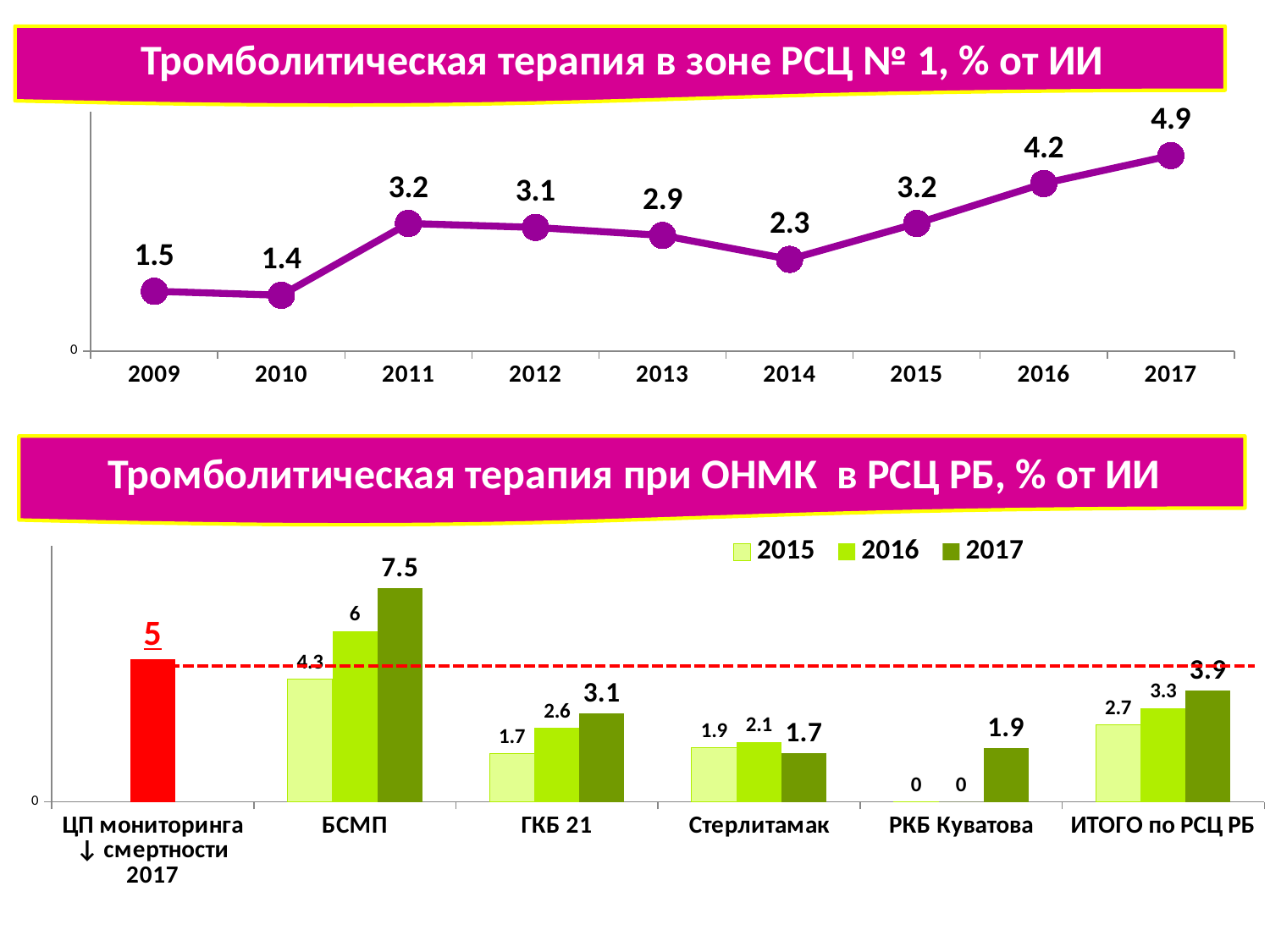
In the bottom chart 'Тромболитическая терапия при ОНМК в РСЦ РБ, % от ИИ', how many series does the legend list? 3 What kind of chart is the top chart 'Тромболитическая терапия в зоне РСЦ № 1, % от ИИ'? line chart In the top chart 'Тромболитическая терапия в зоне РСЦ № 1, % от ИИ', how many years are plotted? 9 In the bottom chart 'Тромболитическая терапия при ОНМК в РСЦ РБ, % от ИИ', what is the difference between the 2017 and 2015 values for ИТОГО по РСЦ РБ? 1.2 In the top chart 'Тромболитическая терапия в зоне РСЦ № 1, % от ИИ', what is the value for 2017? 4.9 In the bottom chart 'Тромболитическая терапия при ОНМК в РСЦ РБ, % от ИИ', what is the 2016 value for ГКБ 21? 2.6 In the bottom chart 'Тромболитическая терапия при ОНМК в РСЦ РБ, % от ИИ', which is larger for Стерлитамак: the 2016 value or the 2017 value? 2016 In the top chart 'Тромболитическая терапия в зоне РСЦ № 1, % от ИИ', what is the value for 2014? 2.3 In the bottom chart 'Тромболитическая терапия при ОНМК в РСЦ РБ, % от ИИ', what is the 2017 value for БСМП? 7.5 In the top chart 'Тромболитическая терапия в зоне РСЦ № 1, % от ИИ', which year has the lowest value? 2010 In the top chart 'Тромболитическая терапия в зоне РСЦ № 1, % от ИИ', what is the difference between the 2017 and 2009 values? 3.4 In the top chart 'Тромболитическая терапия в зоне РСЦ № 1, % от ИИ', which year has the highest value? 2017